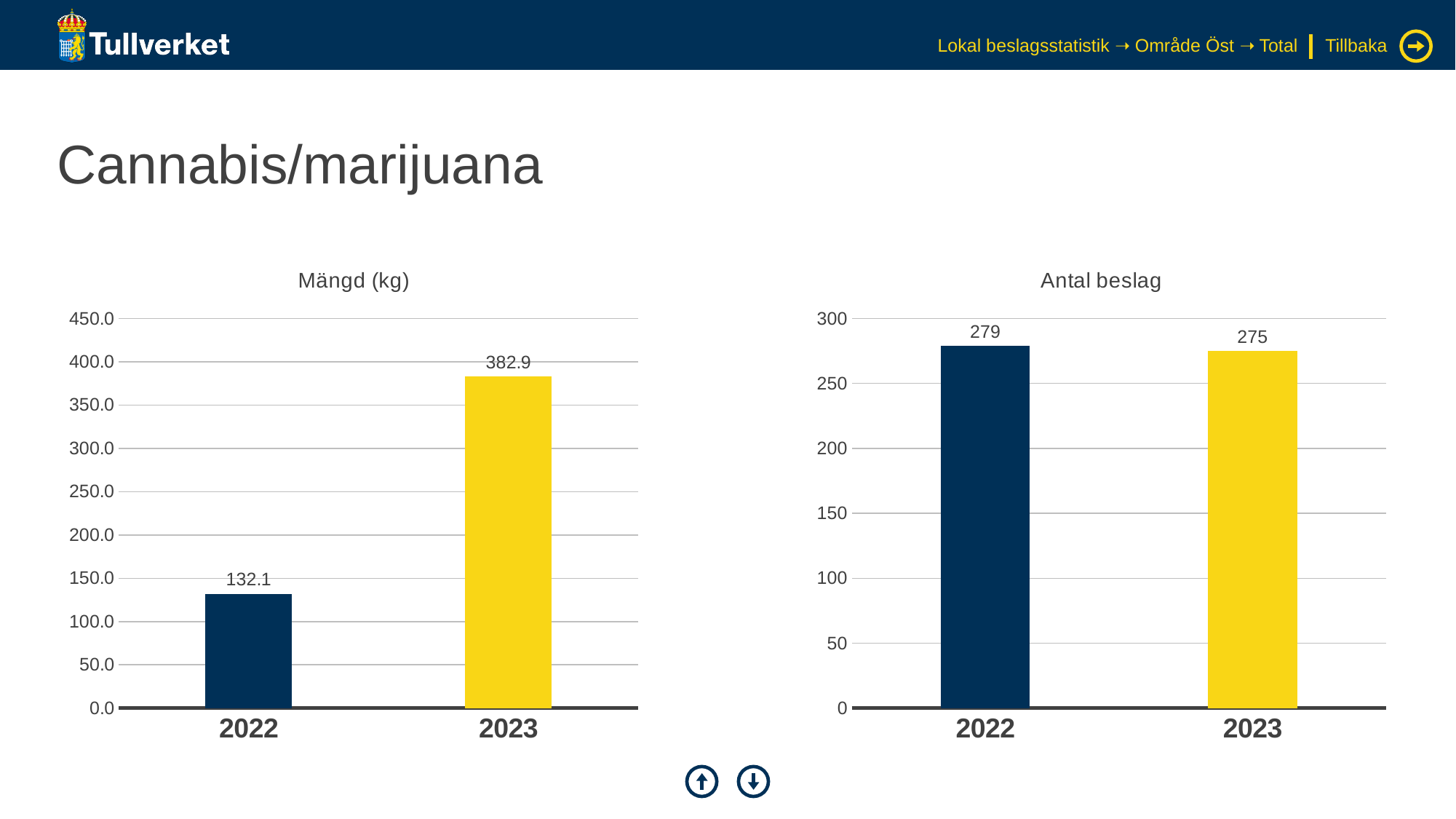
In the 'Antal beslag' chart, is the value for 2023 greater or less than 250? greater In the 'Antal beslag' chart, what is the value for 2022? 279 In the 'Antal beslag' chart, what is the value for 2023? 275 In the 'Antal beslag' chart, what is the difference between the 2022 and 2023 values? 4 In the 'Mängd (kg)' chart, is the value for 2022 greater or less than 150.0? less In the 'Mängd (kg)' chart, what is the value for 2022? 132.1 In the 'Mängd (kg)' chart, which year has the highest value? 2023 In the 'Mängd (kg)' chart, what is the difference between the 2023 and 2022 values? 250.8 What kind of chart is the 'Mängd (kg)' chart? bar chart In the 'Mängd (kg)' chart, do the values rise or fall from 2022 to 2023? rise How many categories are shown on the x axis of the 'Antal beslag' chart? 2 In the 'Mängd (kg)' chart, what is the value for 2023? 382.9